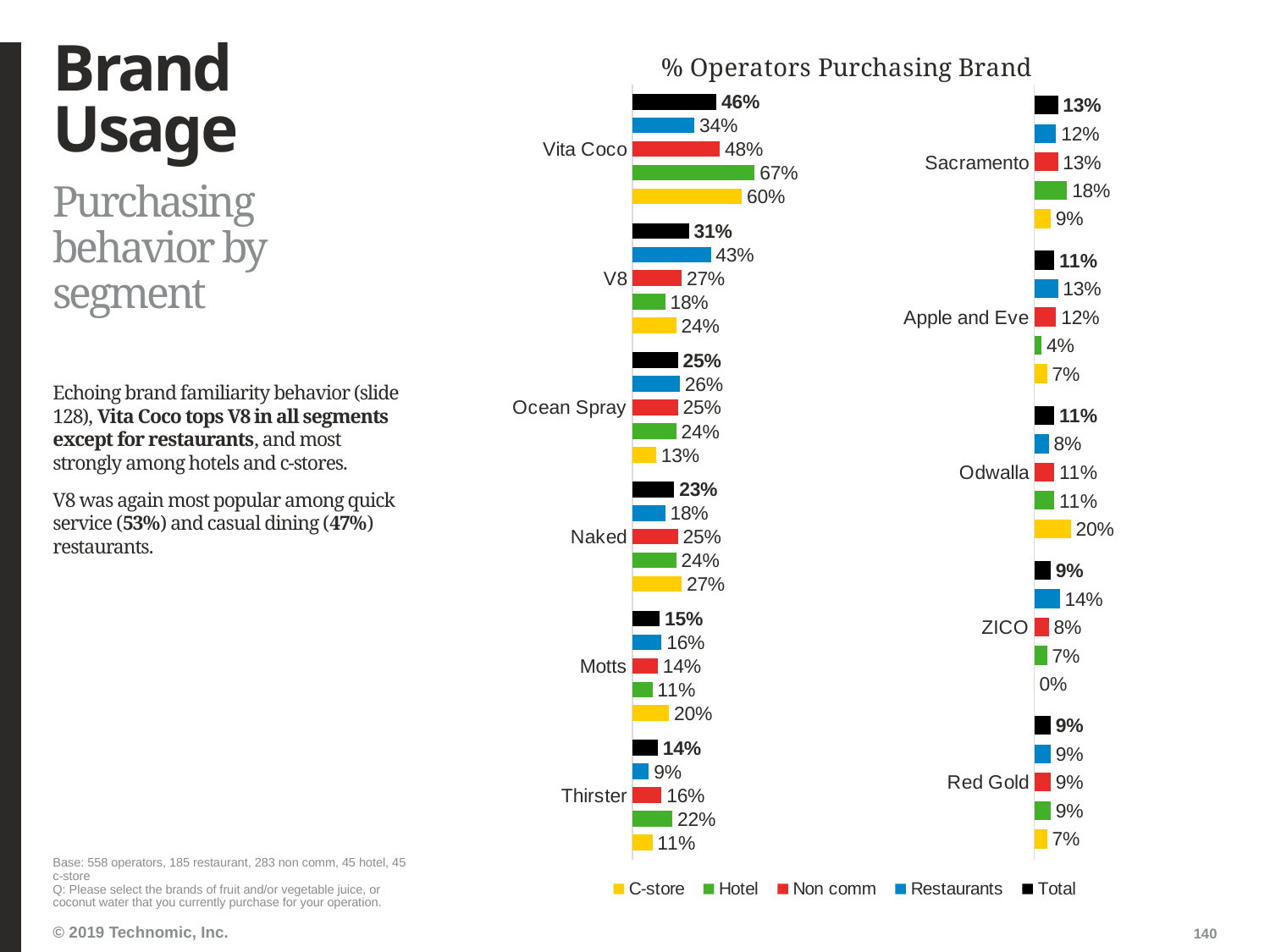
Which brand has the highest Total value in the chart? Vita Coco What type of chart is used to show % Operators Purchasing Brand? Bar chart What is the Restaurants value for V8? 43% What percentage of Hotel operators purchase Vita Coco? 67% How many brands are shown in the % Operators Purchasing Brand chart? 11 Which colour represents the C-store segment in the chart? Yellow What is the C-store value for Odwalla? 20% What is the difference between the Hotel and Restaurants values for Vita Coco? 33 percentage points What is the Total value for Vita Coco in the % Operators Purchasing Brand chart? 46% Which segment has the lowest value for Apple and Eve? Hotel Which is larger for V8: the Restaurants value or the Hotel value? Restaurants How many series does the legend list? 5